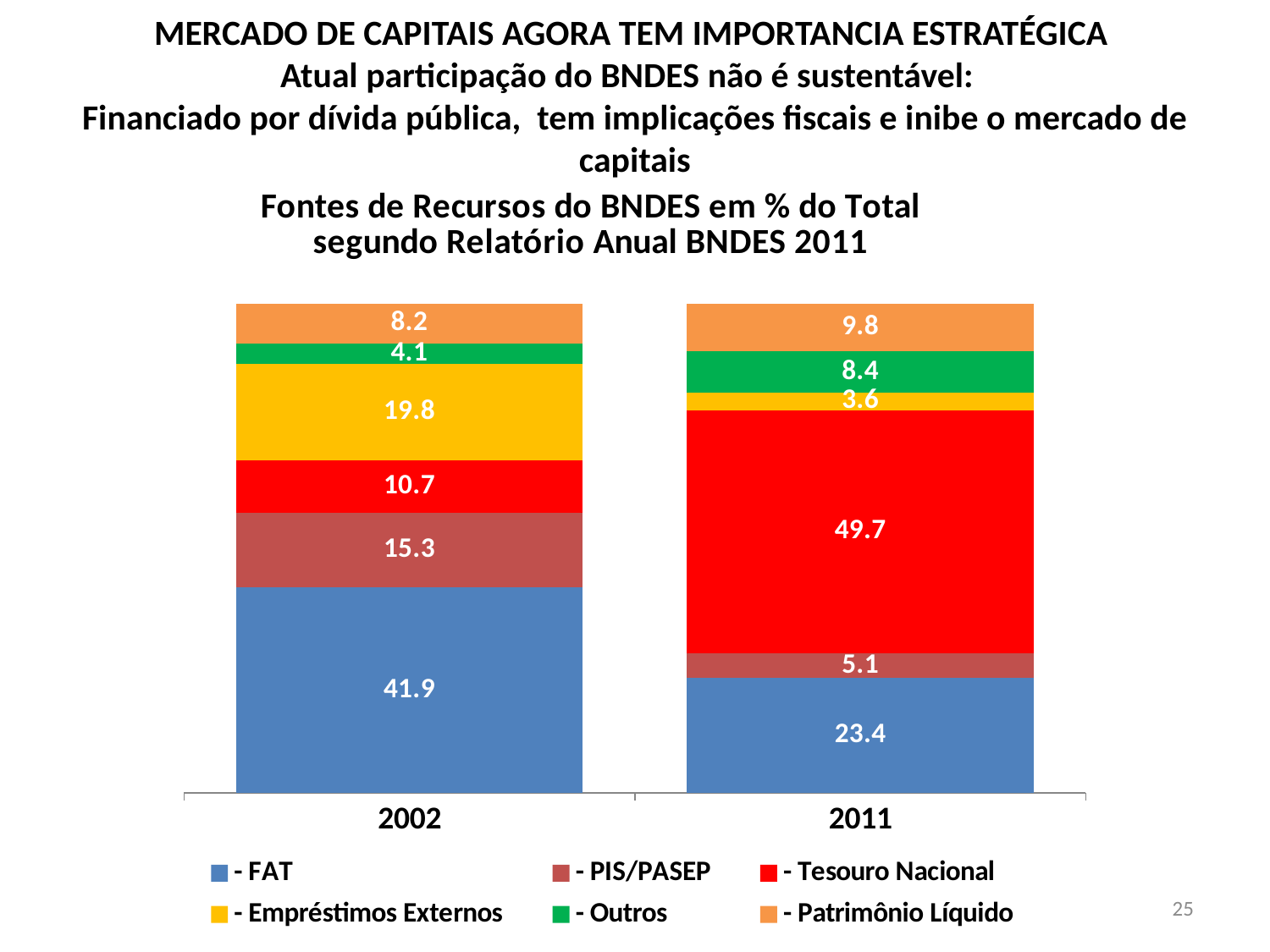
What is the value for Tesouro Nacional in 2011? 49.7 What is the value for FAT in 2002? 41.9 Does the FAT value rise or fall from 2002 to 2011? Fall Which source has the largest share in 2011? Tesouro Nacional Which source has the smallest share in 2002? Outros What is the value for Empréstimos Externos in 2011? 3.6 What is the difference between the Tesouro Nacional values in 2011 and 2002? 39.0 Which is larger, PIS/PASEP in 2002 or PIS/PASEP in 2011? PIS/PASEP in 2002 How many series does the legend list? 6 What is the value for Patrimônio Líquido in 2002? 8.2 What kind of chart is shown on the slide? Stacked bar chart What is the total of the stacked bar for 2002? 100.0